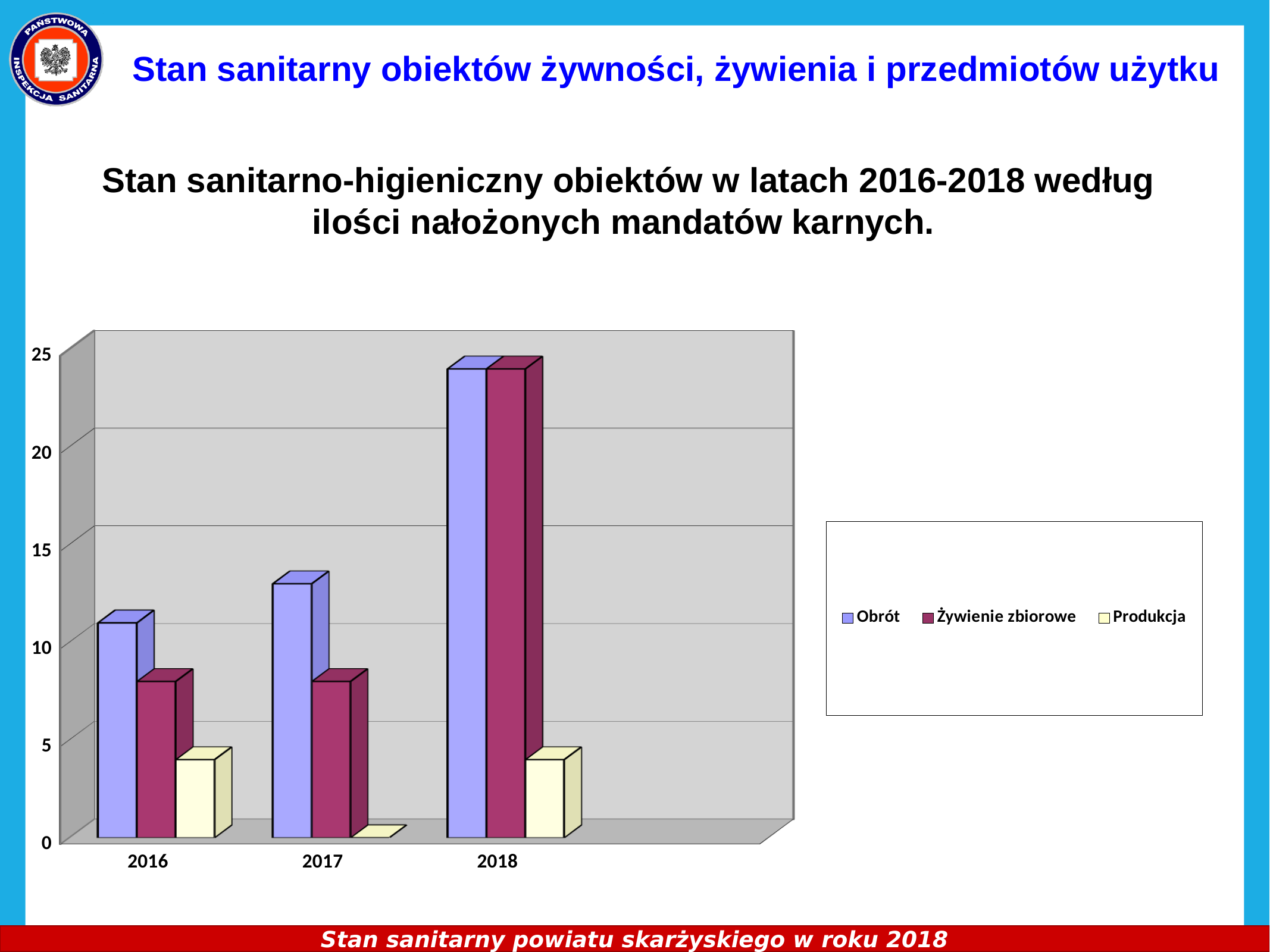
Is the value for Obrót in 2018 greater or less than 20? greater What is the value for Produkcja in 2017? 0 Is the value for Żywienie zbiorowe in 2016 greater or less than 10? less Does the value for Obrót rise or fall from 2016 to 2018? rise How many years are shown on the x axis? 3 In which year is the value for Produkcja the lowest? 2017 How many series does the legend list? 3 What kind of chart is shown on the slide? bar chart In which year is the value for Obrót the highest? 2018 Is the value for Obrót in 2017 greater or less than 15? less In 2016, which is larger: Obrót or Żywienie zbiorowe? Obrót Which series are listed in the legend? Obrót, Żywienie zbiorowe, Produkcja